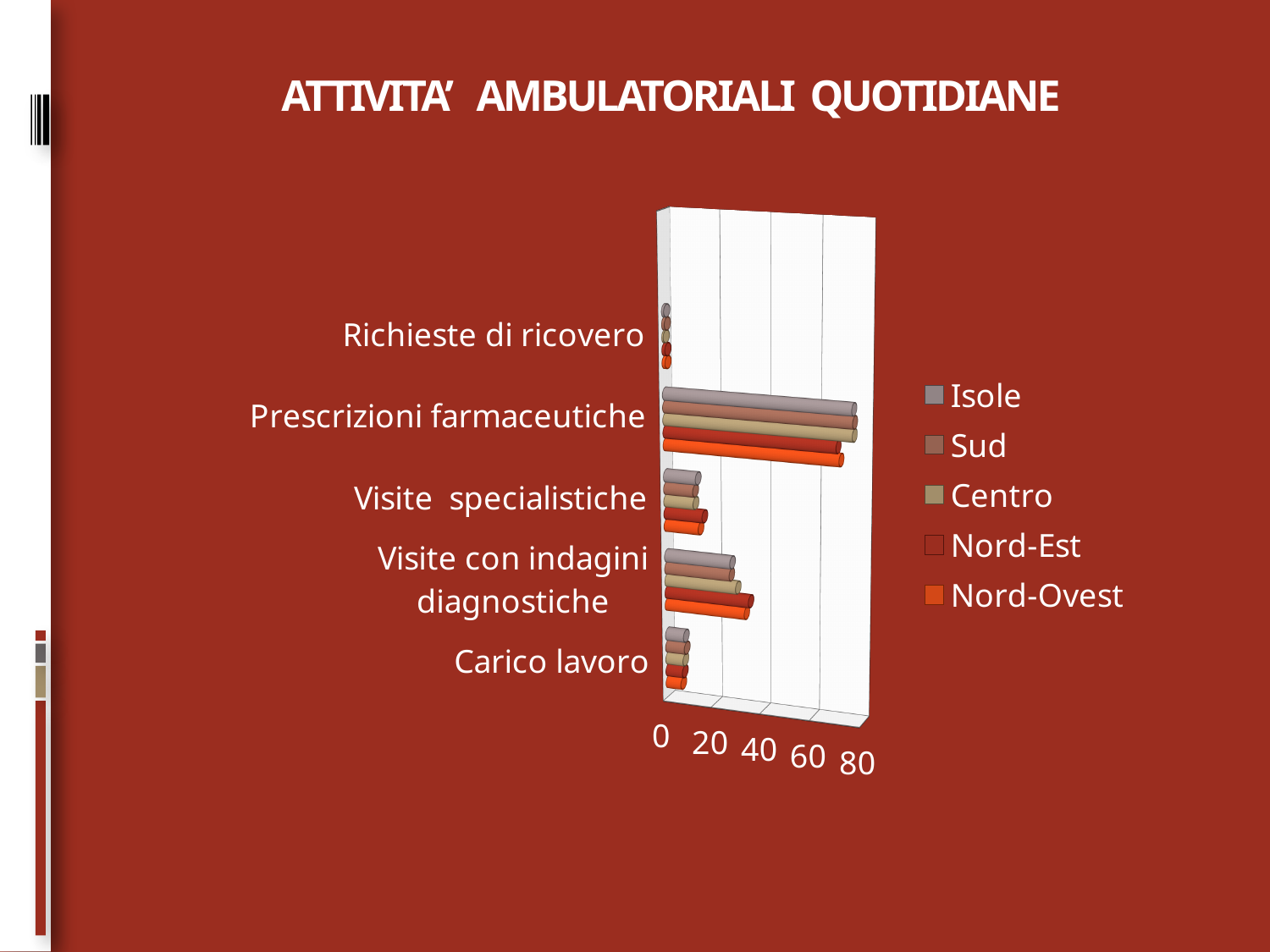
What is the title of the slide containing the chart? ATTIVITA' AMBULATORIALI QUOTIDIANE Which category has the lowest values across all series? Richieste di ricovero Which category has the highest values across all series? Prescrizioni farmaceutiche Is the Sud value for Visite specialistiche greater or less than 20? less Is the Nord-Ovest value for Prescrizioni farmaceutiche greater or less than 60? greater How many categories are plotted on the chart? 5 Is the Isole value for Richieste di ricovero greater or less than 20? less Which is larger for Nord-Ovest: Visite con indagini diagnostiche or Carico lavoro? Visite con indagini diagnostiche Which series is shown in the legend with the orange-red colour? Nord-Ovest How many series does the legend list? 5 What kind of chart is shown on the slide? bar chart